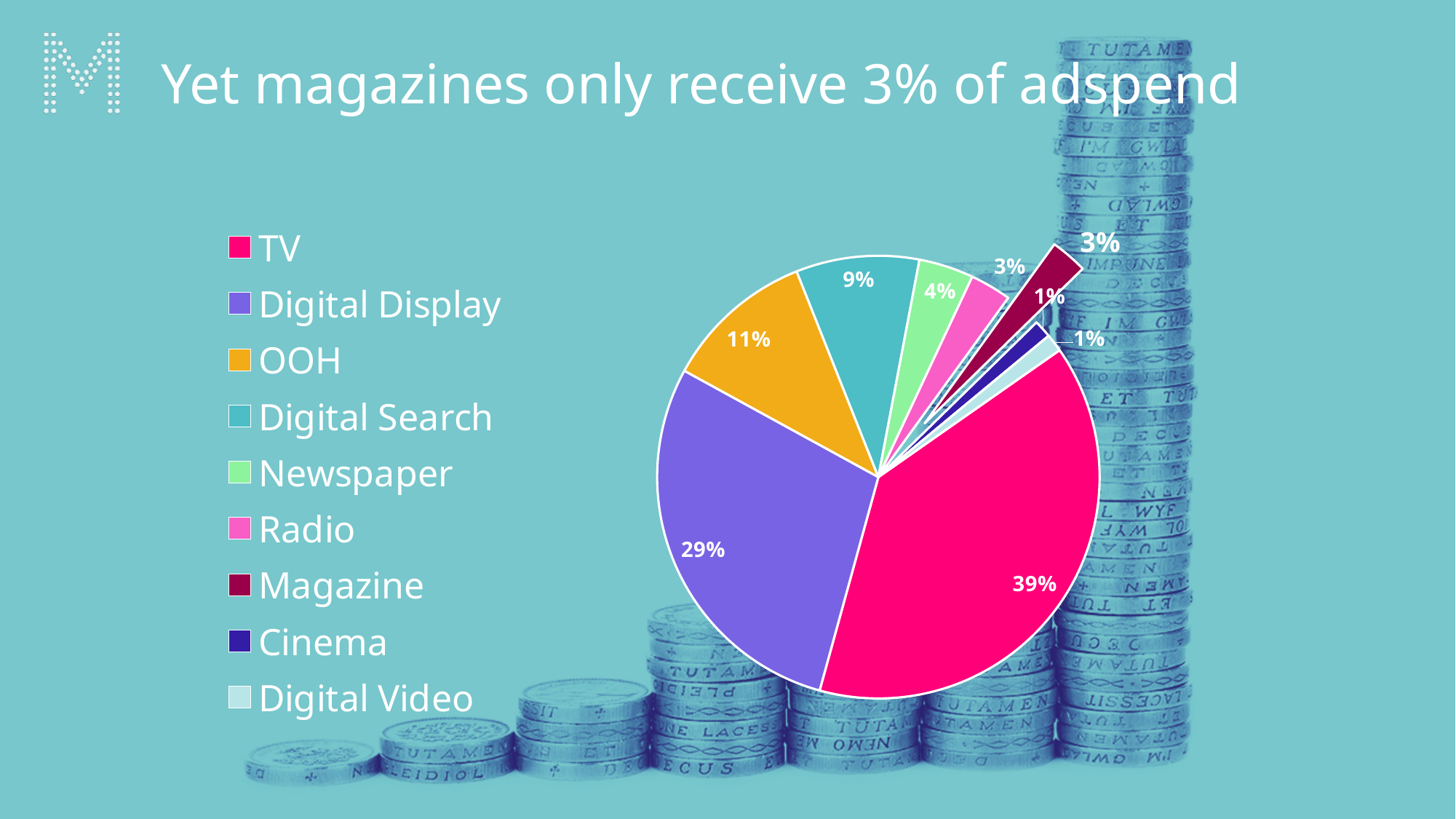
What type of chart is shown on the slide? Pie chart What percentage of adspend goes to Digital Display? 29% How many categories does the legend list? 9 Which slice is pulled out from the rest of the pie? Magazine What percentage is shown for the Magazine slice? 3% Which receives a larger share of adspend, OOH or Digital Search? OOH What is the value shown for OOH in the pie chart? 11% What share does Digital Search receive? 9% What is the title of the slide? Yet magazines only receive 3% of adspend What share of adspend does TV receive according to the pie chart? 39% What is the difference in percentage points between TV and Digital Display? 10 Which category receives the largest share of adspend? TV